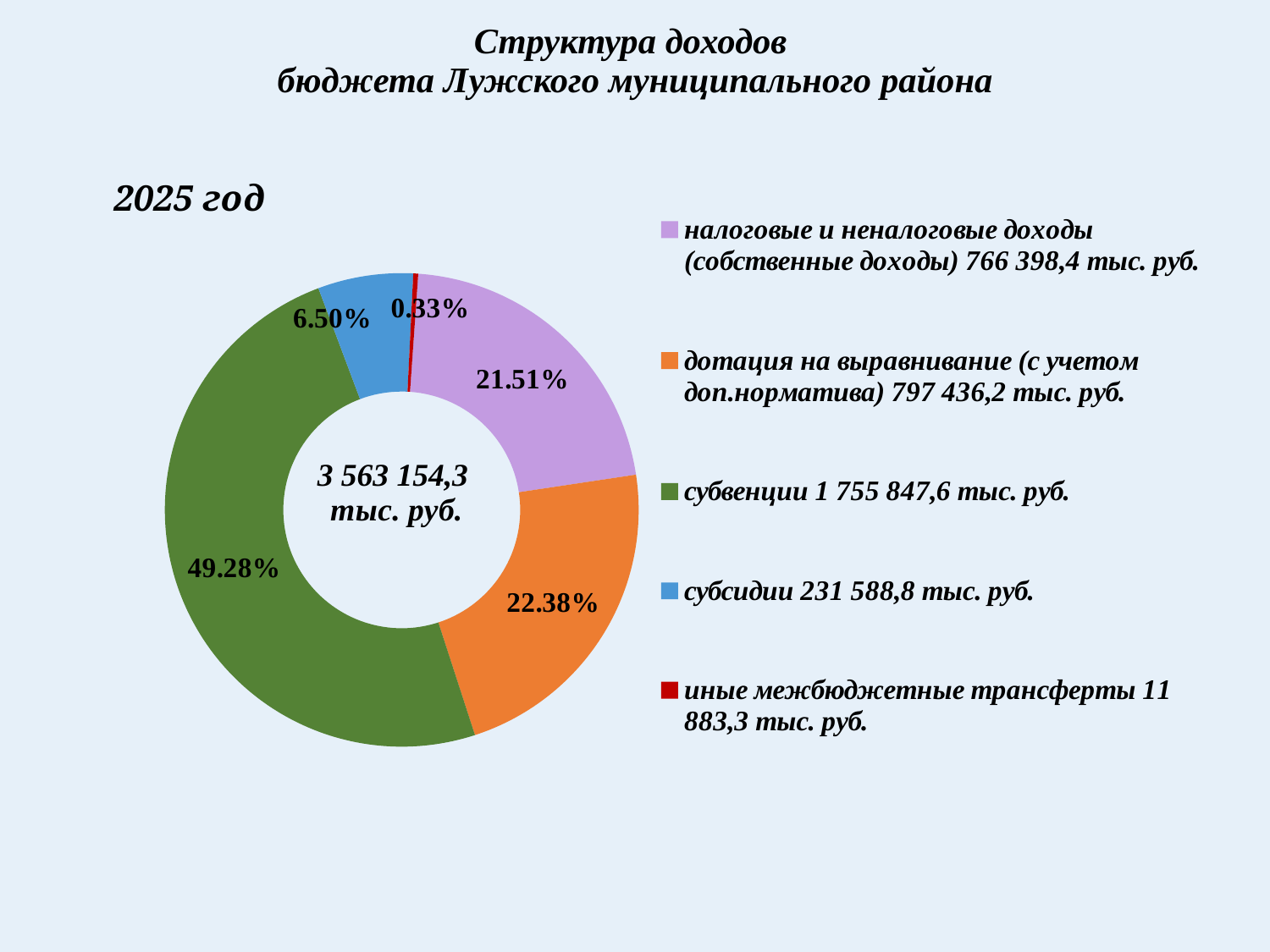
What share of the 2025 budget revenue is дотация на выравнивание? 22.38% What share of the 2025 budget revenue is субвенции? 49.28% What share of the 2025 budget revenue is иные межбюджетные трансферты? 0.33% Which revenue category has the largest share in the 2025 budget? субвенции Which is larger: the share of дотация на выравнивание or the share of налоговые и неналоговые доходы? дотация на выравнивание Which revenue category has the smallest share in the 2025 budget? иные межбюджетные трансферты What is the amount of субсидии given in the legend? 231 588,8 тыс. руб. What is the total revenue amount shown in the centre of the chart? 3 563 154,3 тыс. руб. What kind of chart is shown on the slide? Doughnut (pie) chart How many revenue categories are shown in the chart? 5